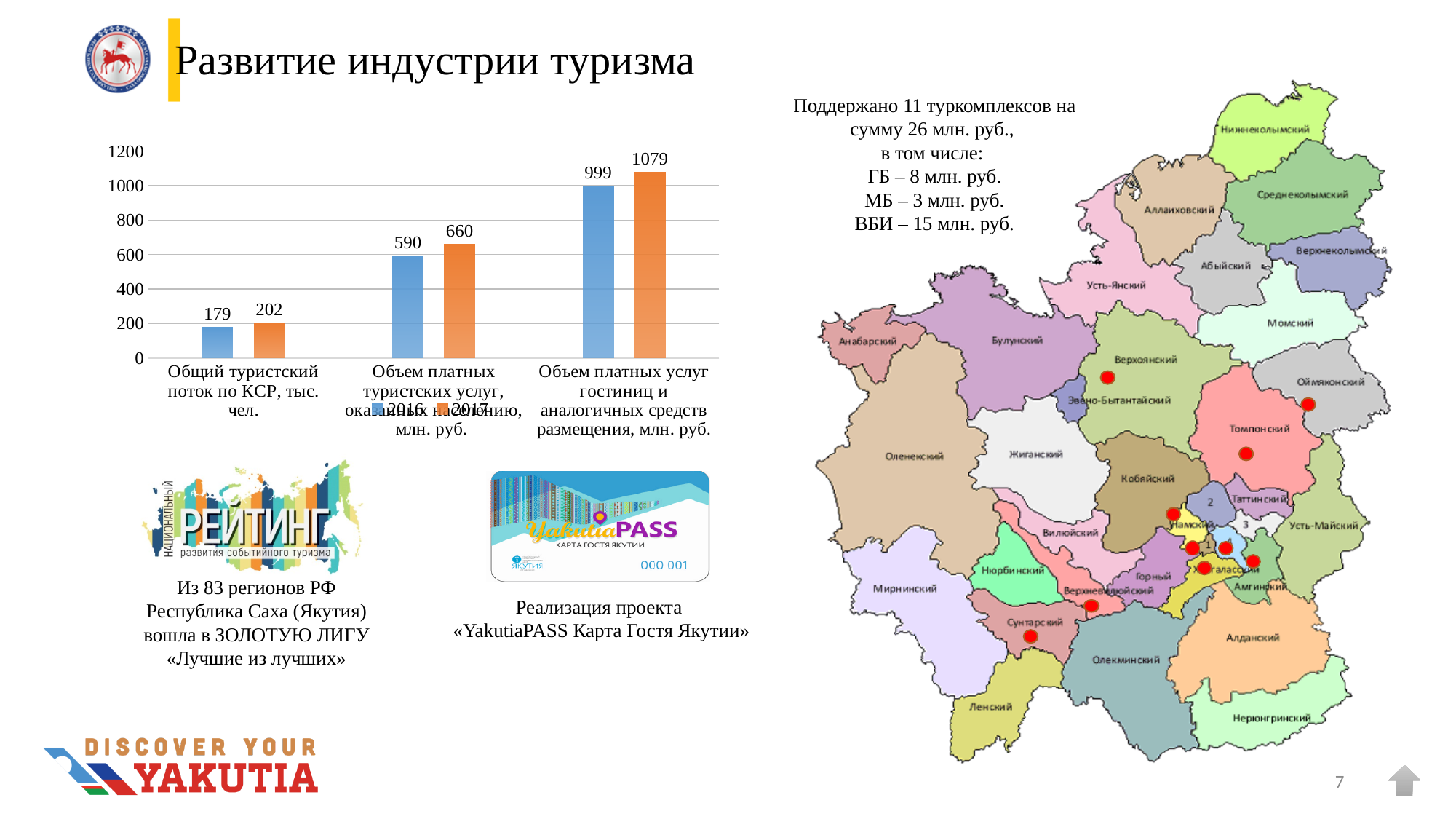
What kind of chart is shown on the slide? bar chart What is the 2017 value for "Объем платных туристских услуг, оказанных населению, млн. руб."? 660 What is the 2016 value for "Общий туристский поток по КСР, тыс. чел."? 179 How many series does the chart legend list? 2 What is the difference between the 2017 and 2016 values for "Объем платных туристских услуг, оказанных населению, млн. руб."? 70 Which category has the lowest 2016 value? Общий туристский поток по КСР, тыс. чел. What is the difference between the 2017 and 2016 values for "Общий туристский поток по КСР, тыс. чел."? 23 Which is larger for "Объем платных услуг гостиниц и аналогичных средств размещения, млн. руб.": the 2016 value or the 2017 value? 2017 What is the 2016 value for "Объем платных услуг гостиниц и аналогичных средств размещения, млн. руб."? 999 How many categories are shown on the x axis of the chart? 3 Which category has the highest 2017 value? Объем платных услуг гостиниц и аналогичных средств размещения, млн. руб. What is the 2017 value for "Объем платных услуг гостиниц и аналогичных средств размещения, млн. руб."? 1079